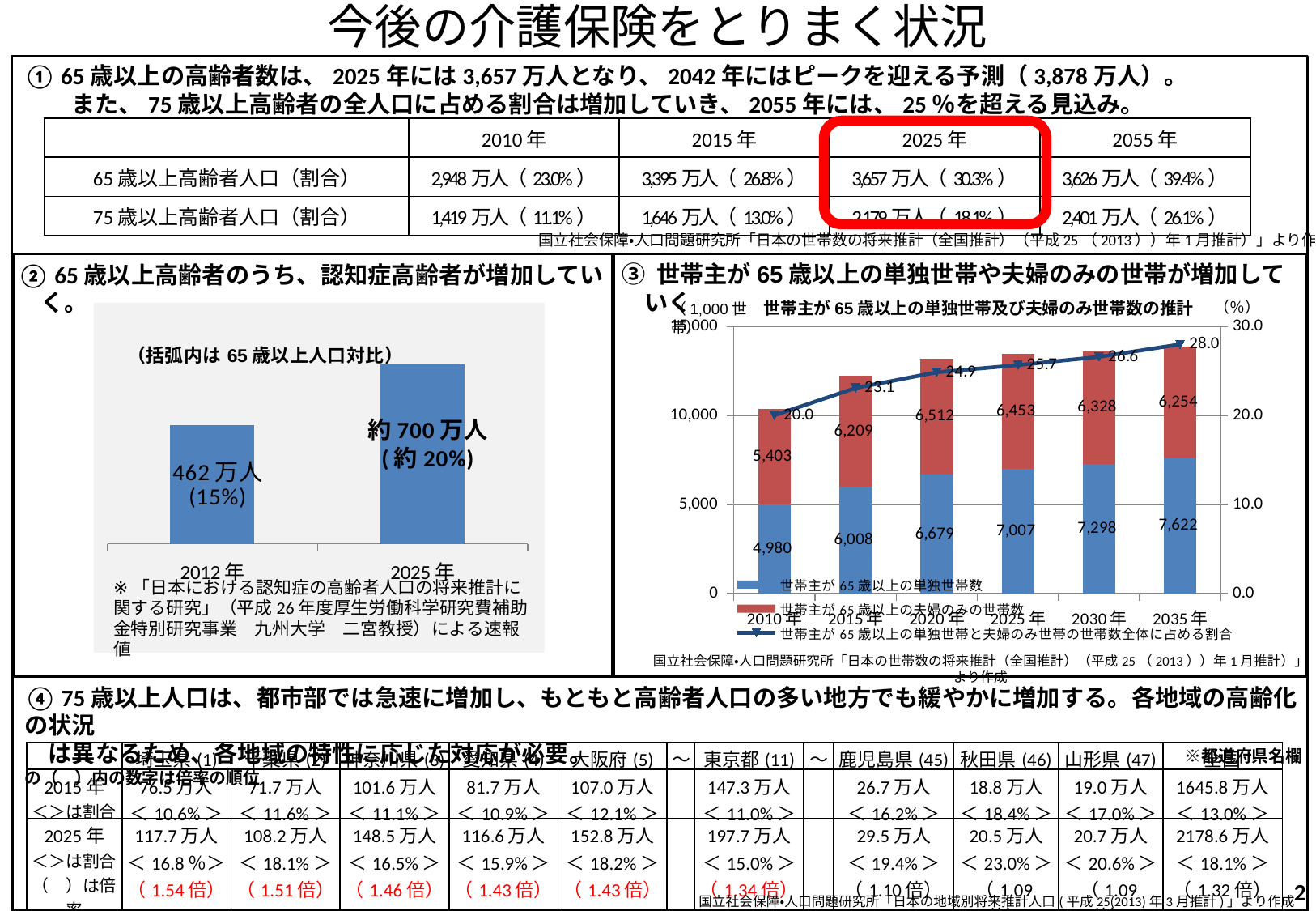
In the chart titled 世帯主が65歳以上の単独世帯及び夫婦のみ世帯数の推計, what percentage does the line show for 2035年? 28.0 In the left bar chart (section ②), what is the value shown for 2012年? 462万人 (15%) In the chart titled 世帯主が65歳以上の単独世帯及び夫婦のみ世帯数の推計, what is the total of the stacked bar for 2025年? 13,460 In the chart titled 世帯主が65歳以上の単独世帯及び夫婦のみ世帯数の推計, what is the difference between the 単独世帯数 values for 2035年 and 2010年? 2,642 In the chart titled 世帯主が65歳以上の単独世帯及び夫婦のみ世帯数の推計, what is the value of 世帯主が65歳以上の夫婦のみの世帯数 for 2020年? 6,512 In the left bar chart (section ②), how many bars (categories) are plotted? 2 In the chart titled 世帯主が65歳以上の単独世帯及び夫婦のみ世帯数の推計, does the line series rise or fall from 2010年 to 2035年? rise In the left bar chart (section ②), which year has the taller bar, 2012年 or 2025年? 2025年 In the chart titled 世帯主が65歳以上の単独世帯及び夫婦のみ世帯数の推計, how many entries does the legend list? 3 In the chart titled 世帯主が65歳以上の単独世帯及び夫婦のみ世帯数の推計, what is the value of 世帯主が65歳以上の単独世帯数 for 2010年? 4,980 In the chart titled 世帯主が65歳以上の単独世帯及び夫婦のみ世帯数の推計, which year has the highest value for 世帯主が65歳以上の単独世帯数? 2035年 In the chart titled 世帯主が65歳以上の単独世帯及び夫婦のみ世帯数の推計, which year has the lowest value for 世帯主が65歳以上の夫婦のみの世帯数? 2010年